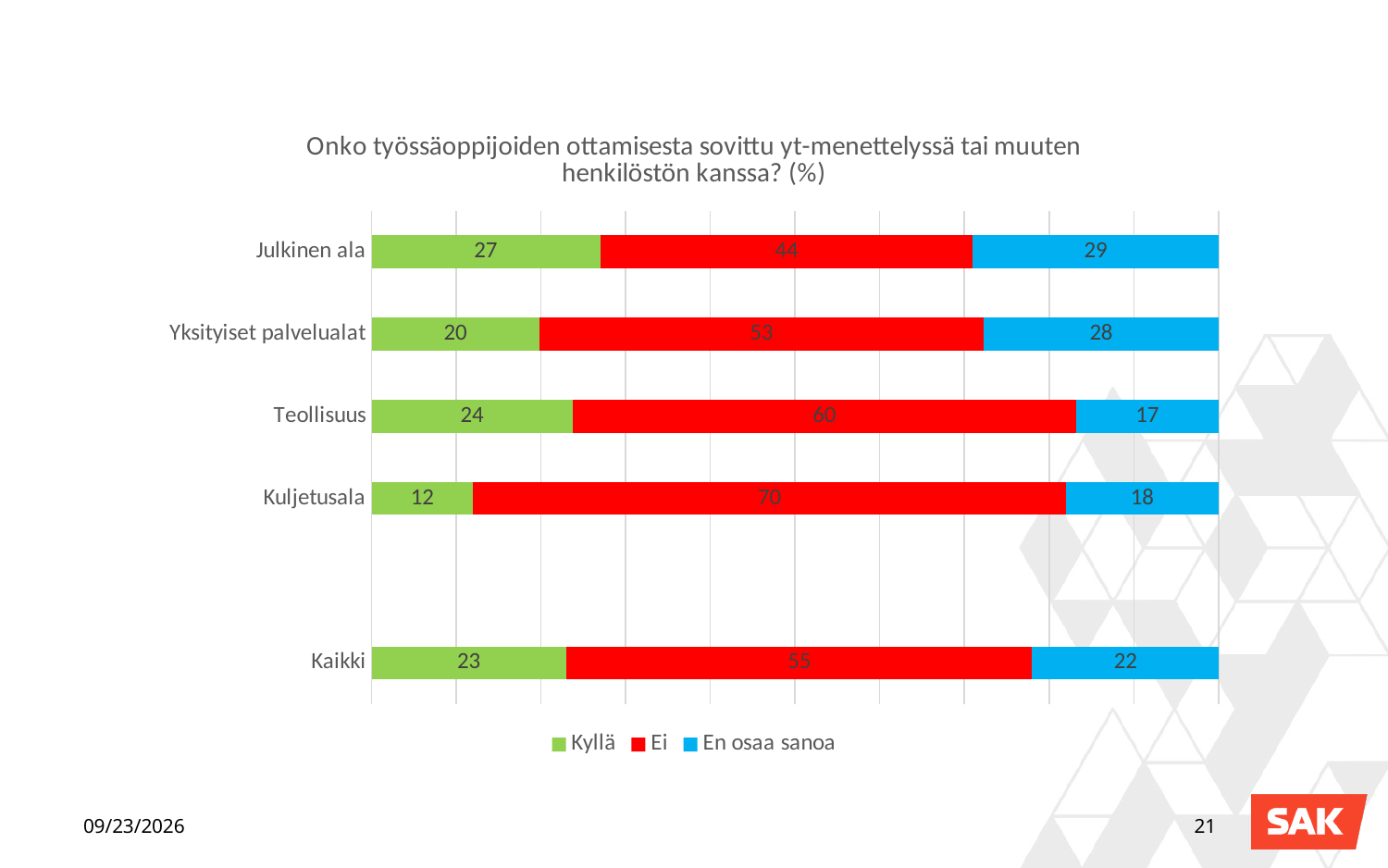
Which colour represents the "Ei" series in the legend? Red How many categories are shown on the chart? 5 Which is larger: the "En osaa sanoa" value for Julkinen ala or for Teollisuus? Julkinen ala What kind of chart is shown on the slide? Stacked bar chart Which category has the highest "Ei" value? Kuljetusala What is the total of the Kaikki bar? 100 What is the difference between the "Ei" values for Teollisuus and Julkinen ala? 16 Which category has the lowest "Kyllä" value? Kuljetusala How many series does the legend list? 3 What is the value for "Ei" in the Kuljetusala bar? 70 What is the value for "En osaa sanoa" in the Yksityiset palvelualat bar? 28 What is the value for "Kyllä" in the Julkinen ala bar? 27